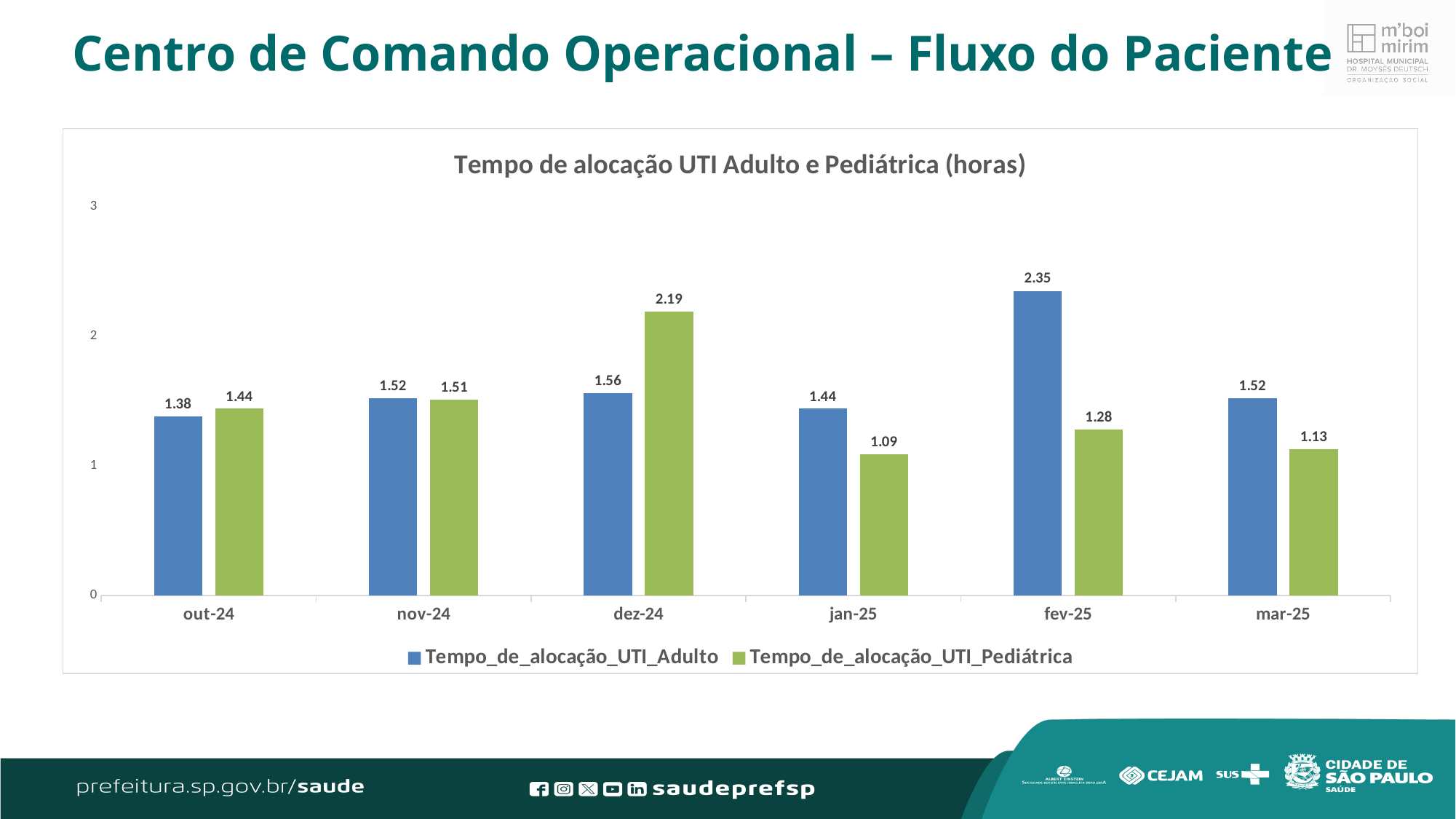
What is the value of Tempo_de_alocação_UTI_Pediátrica for jan-25? 1.09 What is the difference between Tempo_de_alocação_UTI_Adulto and Tempo_de_alocação_UTI_Pediátrica in fev-25? 1.07 How many series does the legend list? 2 Is the value for Tempo_de_alocação_UTI_Adulto in fev-25 greater or less than 2? greater What is the value of Tempo_de_alocação_UTI_Pediátrica for dez-24? 2.19 How many months are shown on the x axis? 6 What kind of chart is shown on the slide? bar chart Which month has the lowest value for Tempo_de_alocação_UTI_Pediátrica? jan-25 What is the title of the chart? Tempo de alocação UTI Adulto e Pediátrica (horas) Which month has the highest value for Tempo_de_alocação_UTI_Adulto? fev-25 In dez-24, which series has the larger value, Tempo_de_alocação_UTI_Adulto or Tempo_de_alocação_UTI_Pediátrica? Tempo_de_alocação_UTI_Pediátrica What is the value of Tempo_de_alocação_UTI_Adulto for fev-25? 2.35